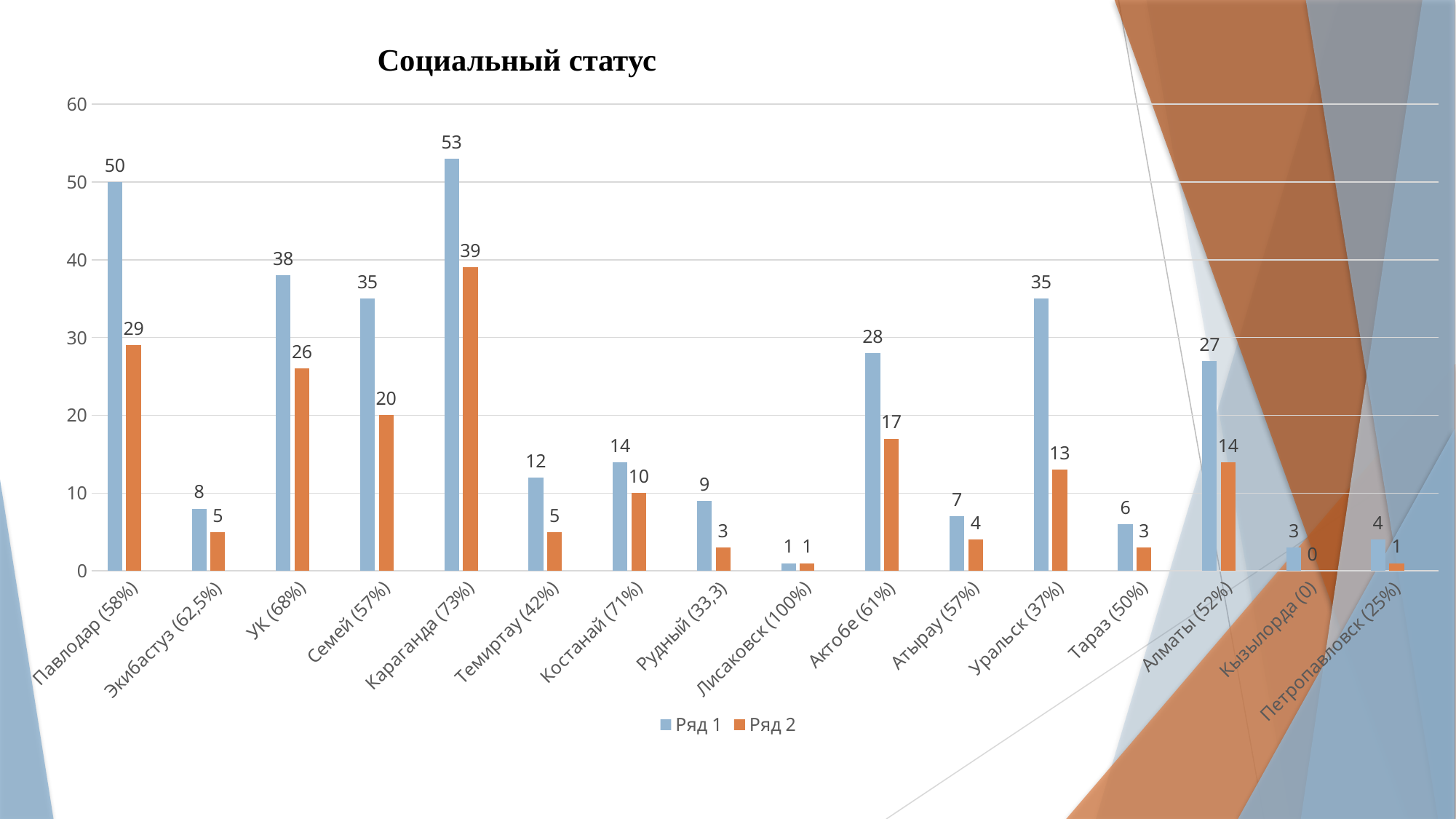
Which is larger: the Ряд 2 value for УК (68%) or the Ряд 2 value for Семей (57%)? УК (68%) What is the value of Ряд 2 for Кызылорда (0)? 0 What is the difference between Ряд 1 and Ряд 2 for Уральск (37%)? 22 What is the value of Ряд 1 for Караганда (73%)? 53 What kind of chart is shown on the slide? Bar chart Which category has the lowest Ряд 1 value? Лисаковск (100%) Which category has the highest Ряд 1 value? Караганда (73%) What is the value of Ряд 2 for Павлодар (58%)? 29 How many categories are shown on the x axis? 16 What is the title of the chart? Социальный статус What is the value of Ряд 1 for Актобе (61%)? 28 How many series does the legend list? 2